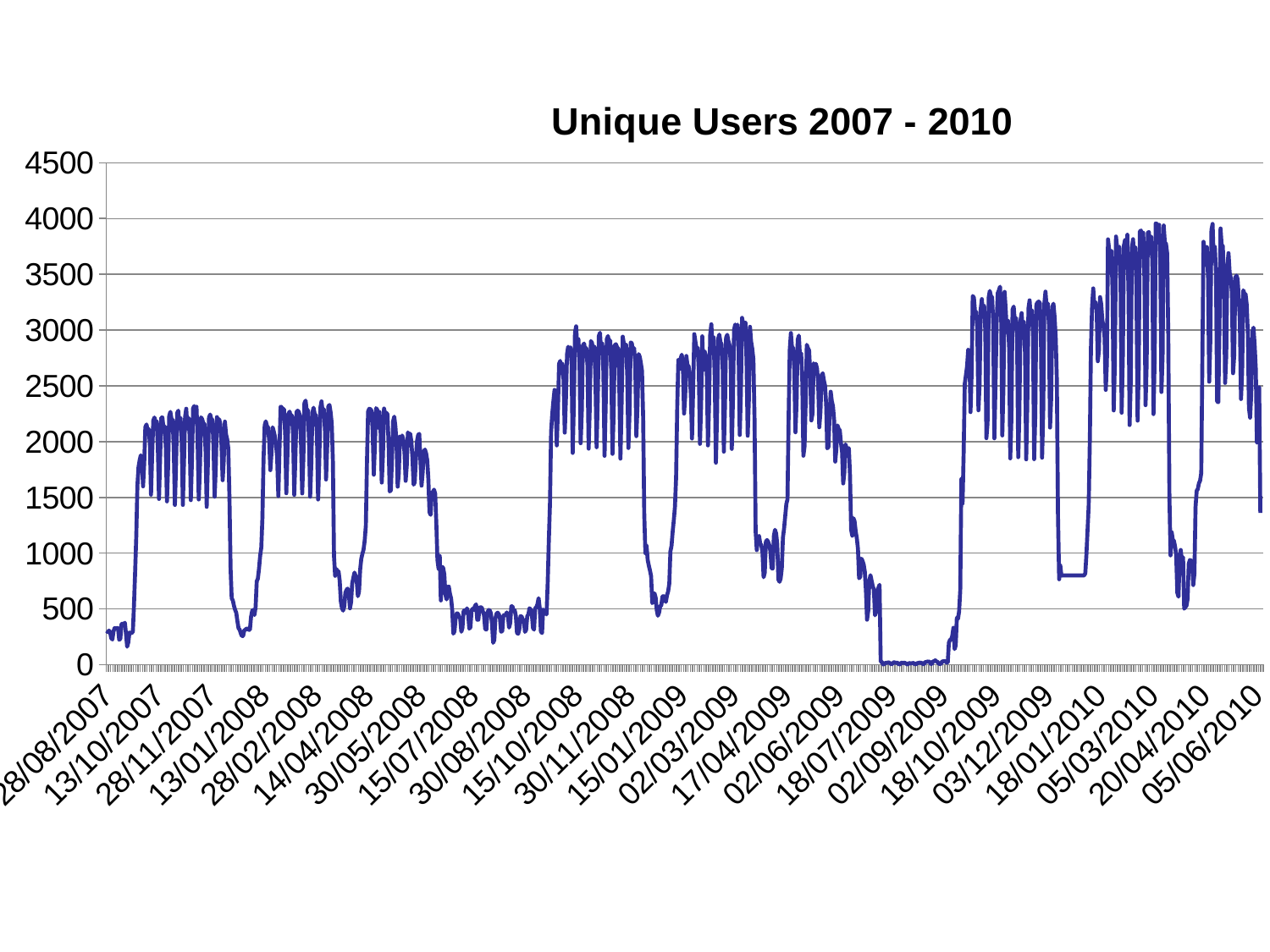
Is the value around 30/08/2008 greater or less than 1000? less What is the highest value shown on the y axis? 4500 Which period has the higher peak: around 18/10/2009 or around 05/03/2010? around 05/03/2010 Is the value around 02/09/2009 greater or less than 500? less Is the value around 15/10/2008 greater or less than 1500? greater Which period has the higher peak: around 13/10/2007 or around 15/10/2008? around 15/10/2008 What is the title of the chart? Unique Users 2007 - 2010 Do the peaks of the line generally rise or fall from 2007 to 2010? rise What kind of chart is shown on the slide? line chart